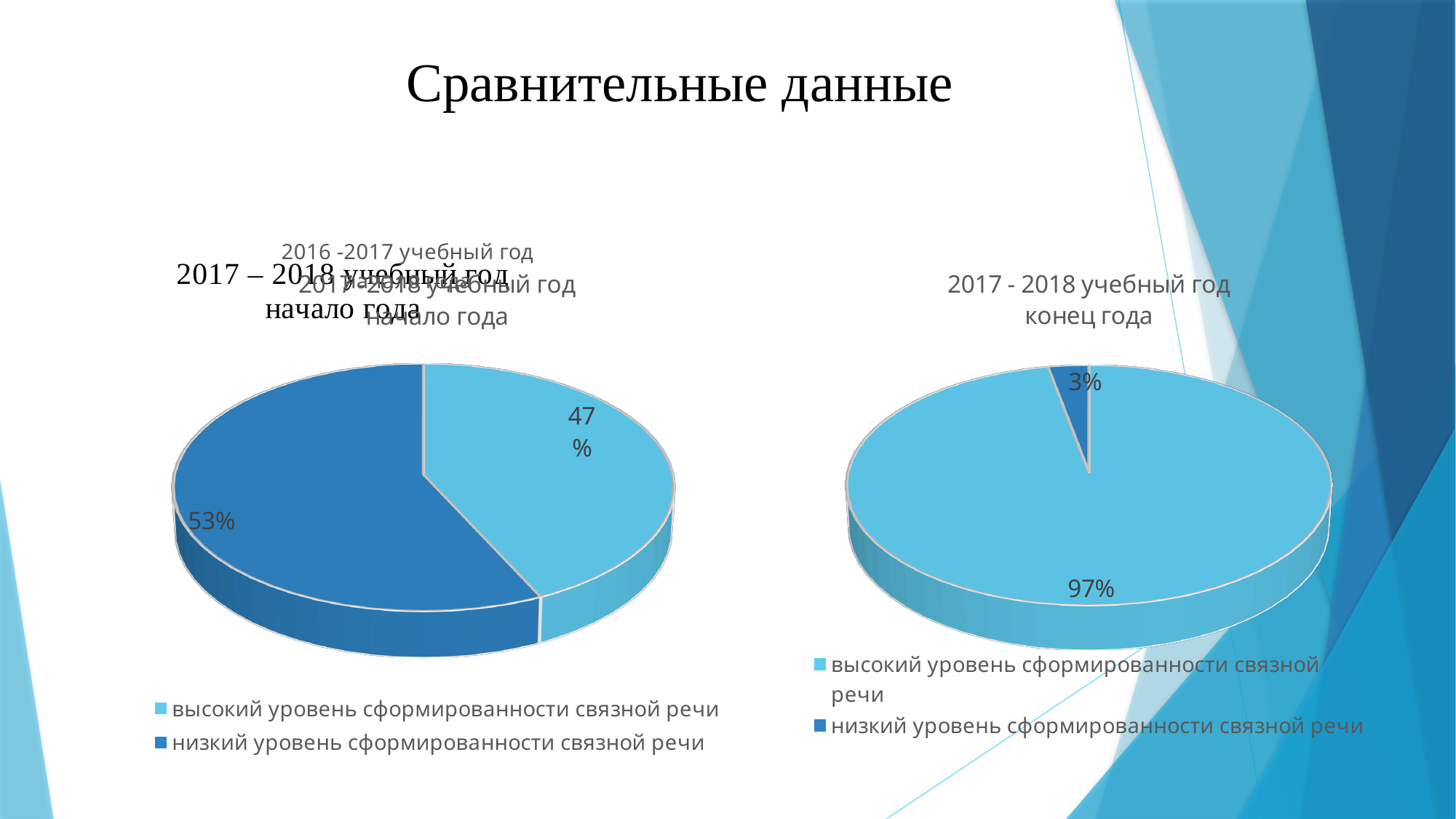
On the right pie chart (конец года), what is the difference between the высокий уровень share and the низкий уровень share? 94% On the left pie chart, what share is labelled for the dark blue slice (низкий уровень сформированности связной речи)? 53% On the right pie chart (конец года), which slice is the largest? высокий уровень сформированности связной речи How many slices does the left pie chart have? 2 On the left pie chart, which slice is larger: высокий уровень or низкий уровень сформированности связной речи? низкий уровень сформированности связной речи On the left pie chart, what is the difference between the низкий уровень share and the высокий уровень share? 6% On the right pie chart (2017 - 2018 учебный год конец года), what share is labelled for низкий уровень сформированности связной речи? 3% What type of chart is used on the right side of the slide (2017 - 2018 учебный год конец года)? pie chart On the left pie chart, what share is labelled for the light blue slice (высокий уровень сформированности связной речи)? 47% How many entries does the legend of the right pie chart list? 2 On the right pie chart (2017 - 2018 учебный год конец года), what share is labelled for высокий уровень сформированности связной речи? 97% On the right pie chart (конец года), which slice is the smallest? низкий уровень сформированности связной речи